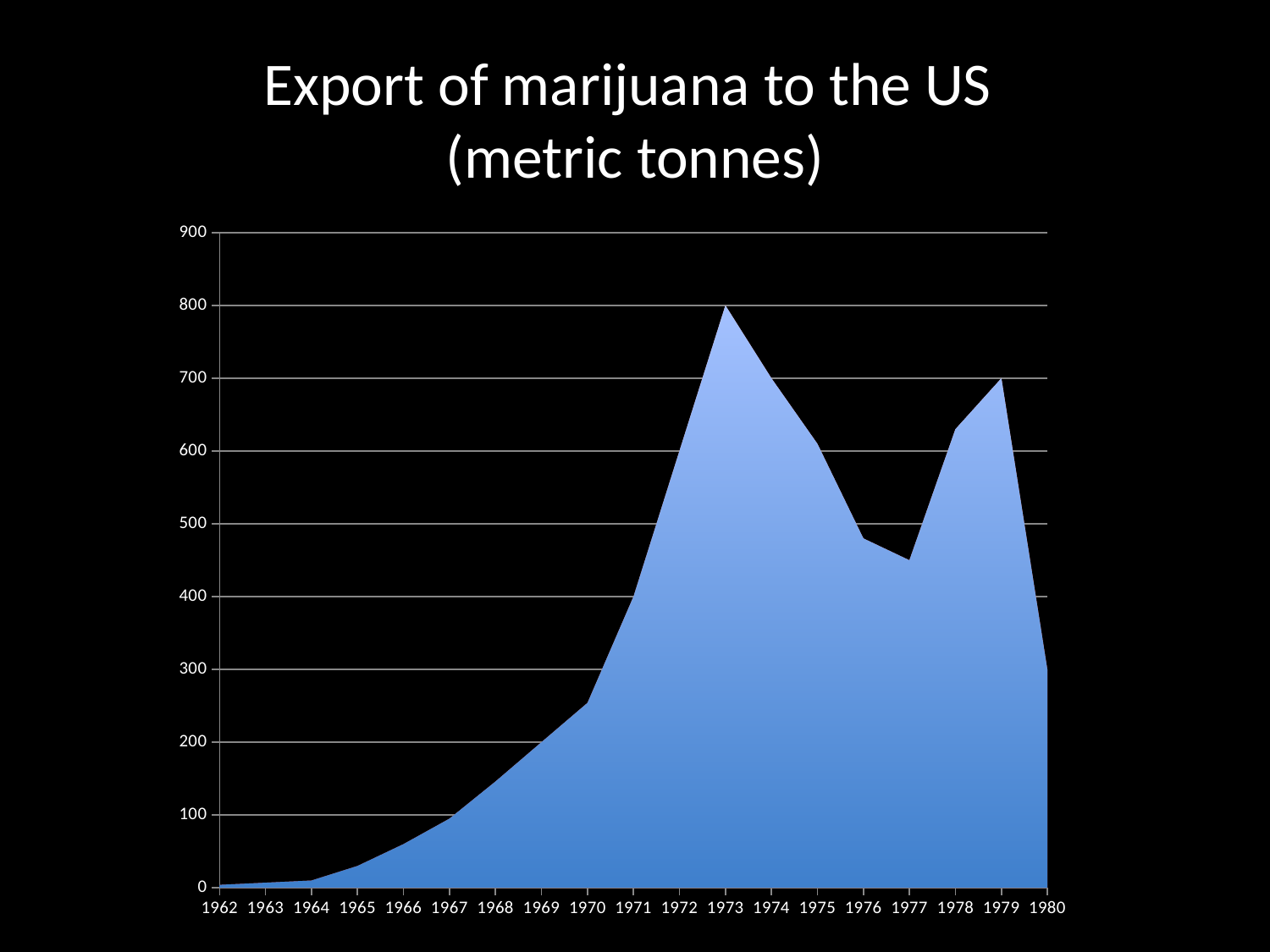
What is the export value for 1973? 800 Which year has the highest export value? 1973 Which year has the larger export value, 1973 or 1979? 1973 What is the difference between the export values for 1973 and 1979? 100 Do the export values rise or fall from 1962 to 1973? rise Is the value for 1977 greater or less than 500? less What is the title of the chart? Export of marijuana to the US (metric tonnes) What kind of chart is shown on the slide? area chart How many years are plotted along the x axis? 19 What is the export value for 1979? 700